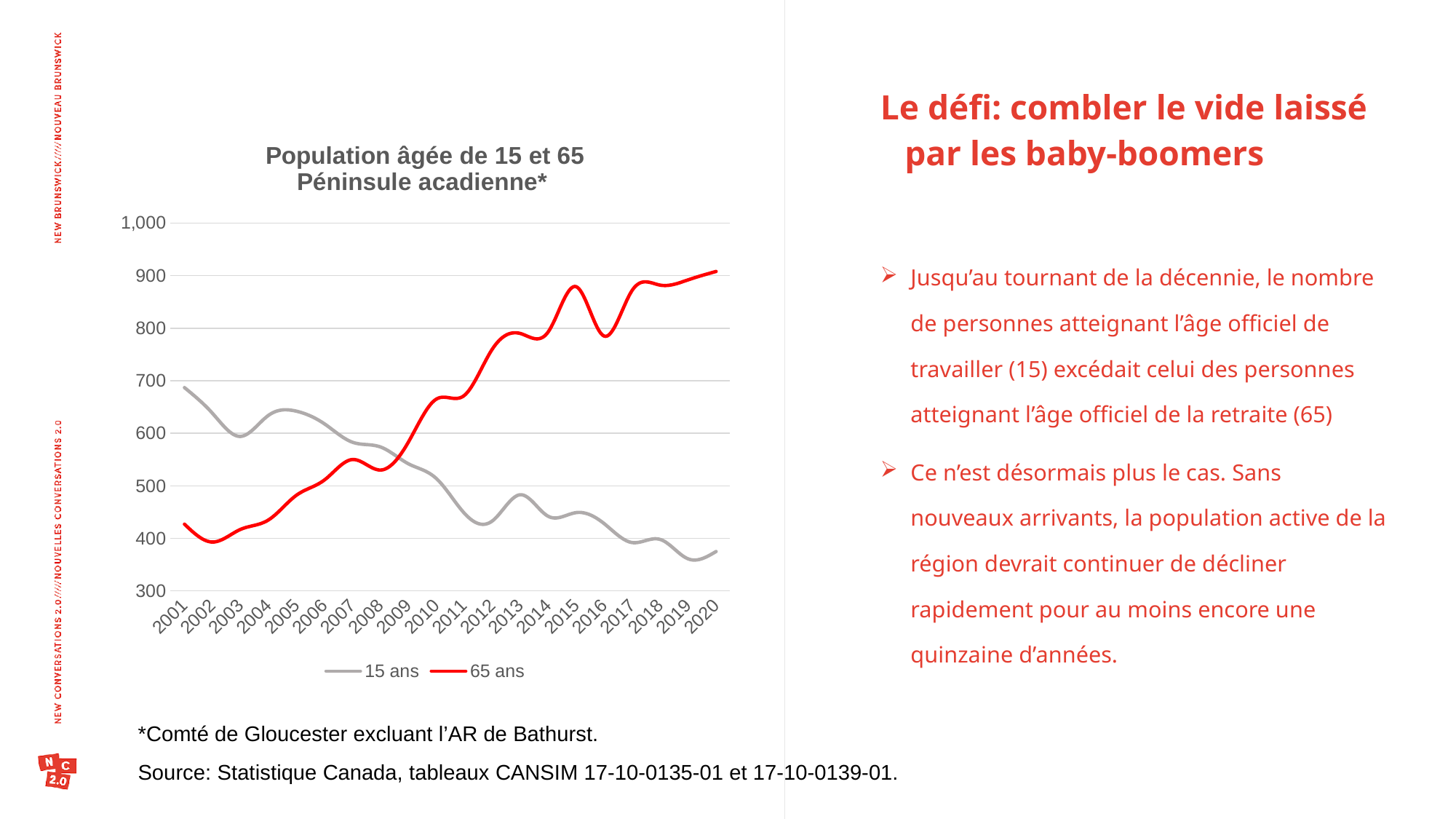
How many years are shown along the x axis of the chart? 20 Does the 15 ans series generally rise or fall from 2001 to 2020? Fall How many series does the chart's legend list? 2 In 2020, which series has the higher value, 15 ans or 65 ans? 65 ans In 2001, which series has the higher value, 15 ans or 65 ans? 15 ans Does the 65 ans series generally rise or fall from 2001 to 2020? Rise What kind of chart is shown on the slide? Line chart Is the value for 15 ans in 2001 greater or less than 600? greater What is the title of the chart? Population âgée de 15 et 65 Péninsule acadienne* Which series is drawn in red in the chart? 65 ans Is the value for 65 ans in 2001 greater or less than 500? less In which year does the 15 ans series reach its highest value? 2001